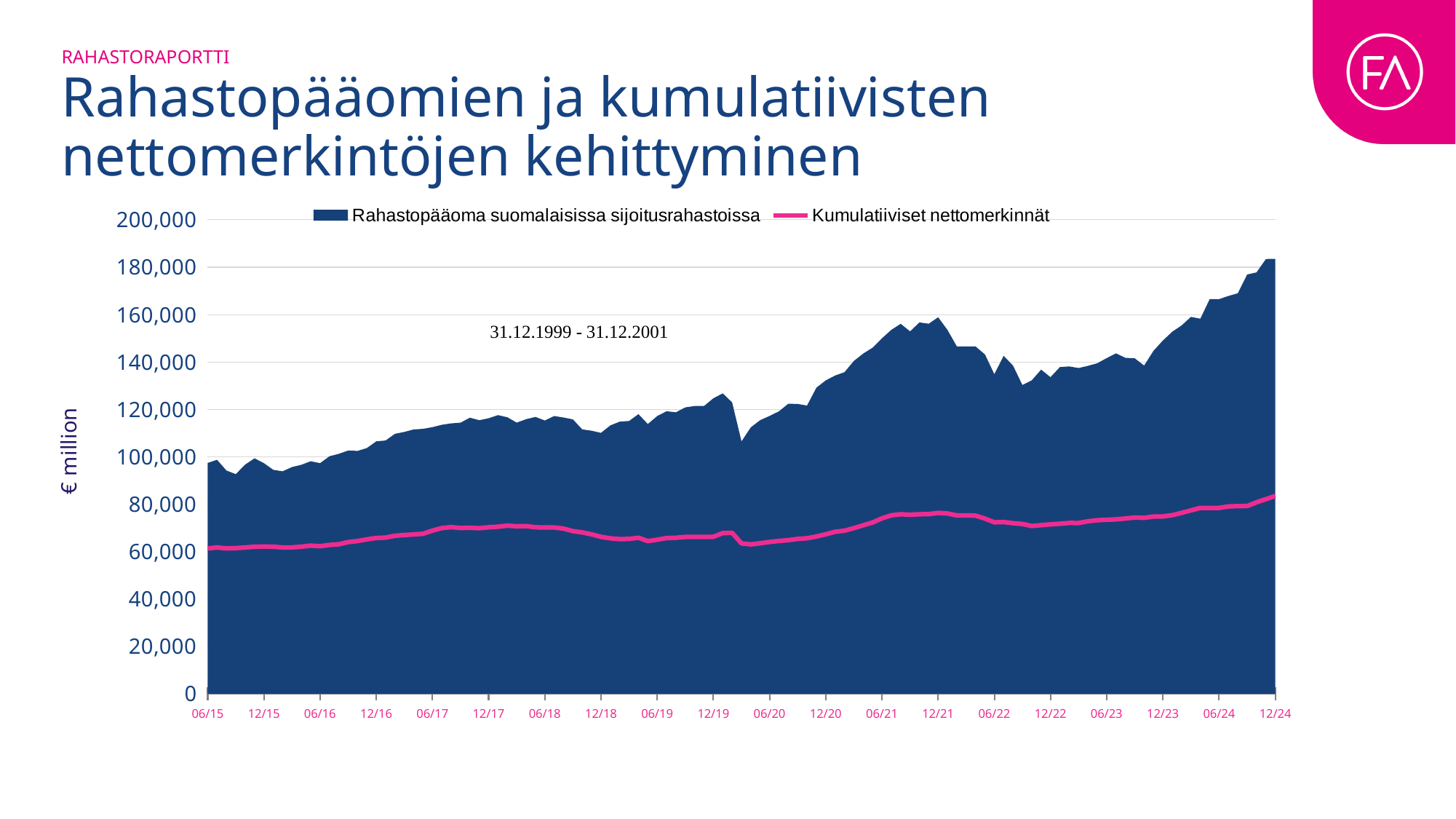
At which x-axis date does Rahastopääoma suomalaisissa sijoitusrahastoissa reach its highest value? 12/24 Is the value of Rahastopääoma suomalaisissa sijoitusrahastoissa at 06/15 greater or less than 120,000? less Does Rahastopääoma suomalaisissa sijoitusrahastoissa rise or fall overall from 06/15 to 12/24? rise How many date labels are shown along the x axis of the chart? 20 Is the value of Kumulatiiviset nettomerkinnät at 06/15 greater or less than 40,000? greater What kind of chart is shown on the slide? Area chart with a line series Is the value of Rahastopääoma suomalaisissa sijoitusrahastoissa at 12/24 greater or less than 160,000? greater Which series is drawn as a pink line in the chart? Kumulatiiviset nettomerkinnät How many series does the chart legend list? 2 What is the label on the vertical axis of the chart? € million At 12/24, which is larger: Rahastopääoma suomalaisissa sijoitusrahastoissa or Kumulatiiviset nettomerkinnät? Rahastopääoma suomalaisissa sijoitusrahastoissa